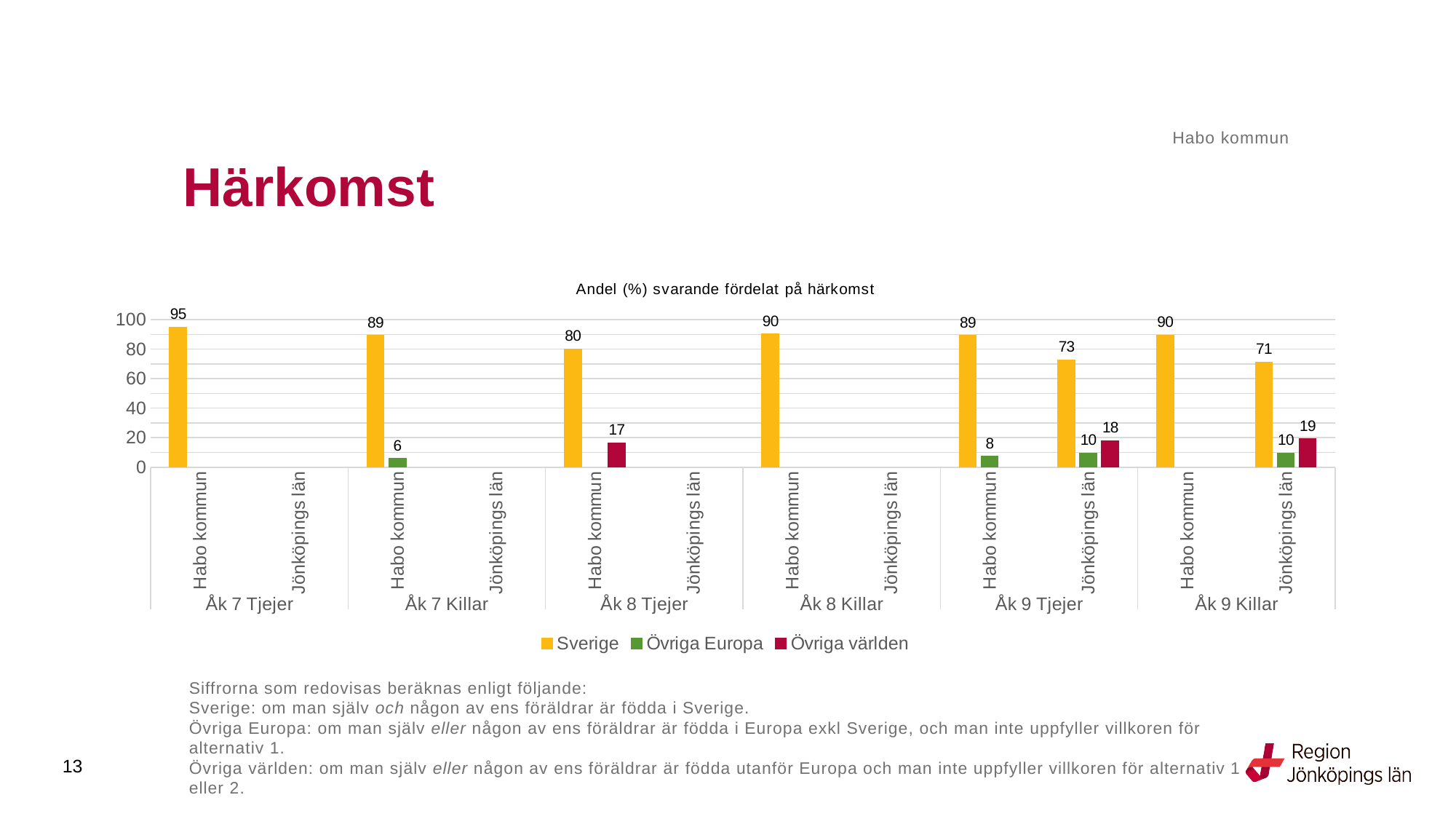
What is the Övriga Europa value for Habo kommun in Åk 7 Killar? 6 What is the difference between the Sverige value for Habo kommun and for Jönköpings län in Åk 9 Tjejer? 16 What kind of chart is shown? Bar chart What is the Sverige value for Jönköpings län in Åk 9 Killar? 71 Which is larger in Åk 9 Killar for Jönköpings län: Övriga Europa or Övriga världen? Övriga världen Which group has the lowest Sverige value for Habo kommun? Åk 8 Tjejer What is the title of the chart? Andel (%) svarande fördelat på härkomst How many series does the legend list? 3 What is the Sverige value for Habo kommun in Åk 7 Tjejer? 95 What is the Övriga världen value for Habo kommun in Åk 8 Tjejer? 17 Which group has the highest Sverige value for Habo kommun? Åk 7 Tjejer What is the Övriga världen value for Jönköpings län in Åk 9 Tjejer? 18